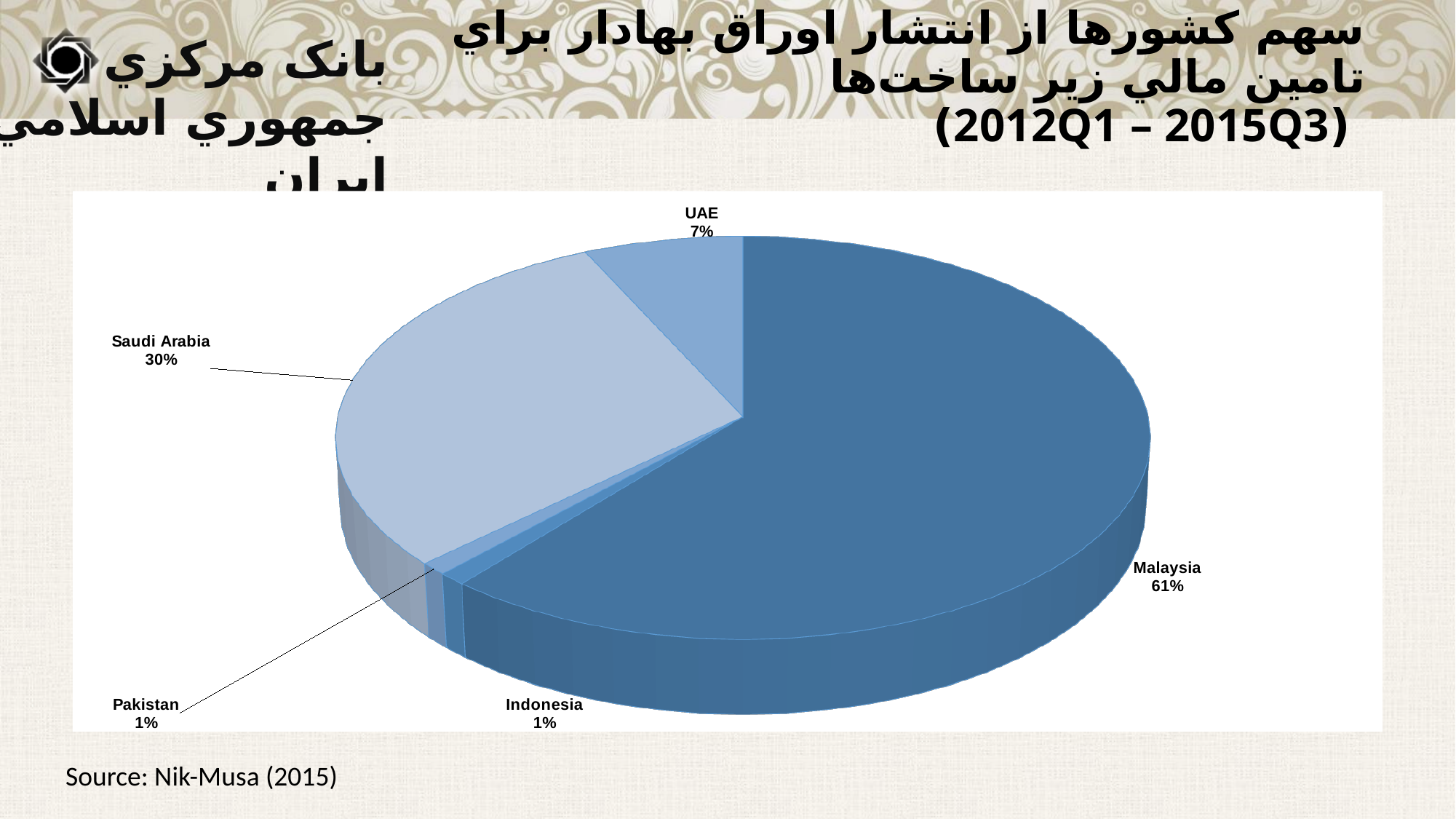
What is the combined share of Pakistan and Indonesia? 2% What is the value shown for Pakistan? 1% What source is cited below the chart? Nik-Musa (2015) How many countries are shown in the pie chart? 5 What kind of chart is shown on the slide? Pie chart What is the difference in percentage points between Malaysia's share and Saudi Arabia's share? 31 Which country has the larger share, Saudi Arabia or UAE? Saudi Arabia What is the value shown for UAE? 7% What is the difference in percentage points between Saudi Arabia's share and UAE's share? 23 What is the value shown for Saudi Arabia? 30% What share of the pie does Malaysia hold? 61% Which country has the largest slice of the pie? Malaysia